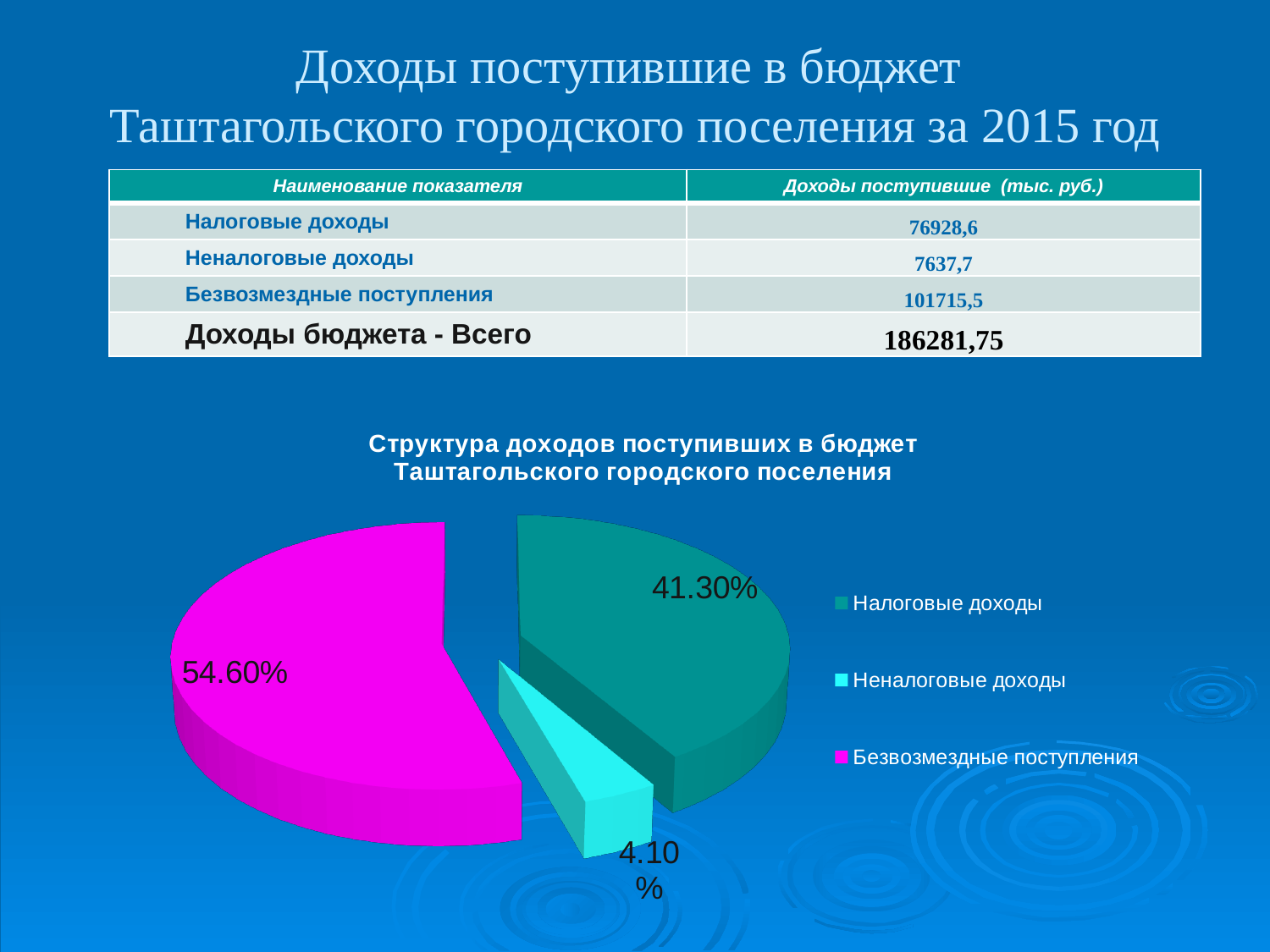
What share of the pie does Налоговые доходы have? 41.30% What share of the pie does Безвозмездные поступления have? 54.60% Which category has the largest slice of the pie? Безвозмездные поступления What colour is the Безвозмездные поступления slice in the pie chart? magenta What is the title of the pie chart? Структура доходов поступивших в бюджет Таштагольского городского поселения What is the difference in percentage points between the Безвозмездные поступления slice and the Налоговые доходы slice? 13.30 How many entries does the legend of the pie chart list? 3 Which slice is larger, Налоговые доходы or Неналоговые доходы? Налоговые доходы Which category has the smallest slice of the pie? Неналоговые доходы What share of the pie does Неналоговые доходы have? 4.10% What kind of chart is shown on the slide? pie chart How many slices does the pie chart have? 3